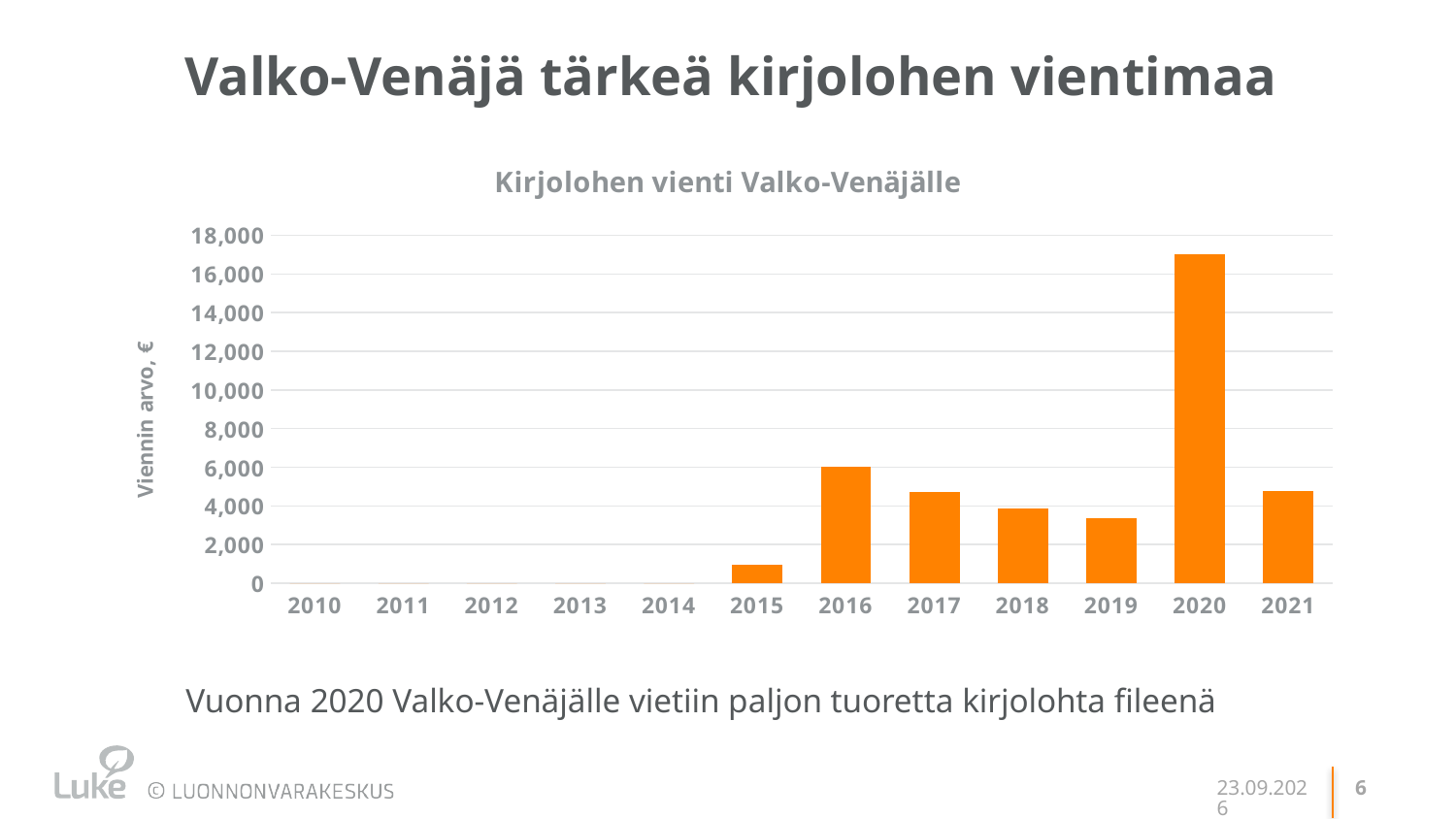
How many years on the chart show no visible bar? 5 Is the value for 2020 greater or less than 16,000? greater Do the values rise or fall from 2016 to 2019? fall How many years are shown on the x axis? 12 Is the value for 2016 greater or less than 4,000? greater Which year has the highest export value? 2020 Is the value for 2015 greater or less than 2,000? less What is the label of the vertical axis? Viennin arvo, € What is the title of the chart? Kirjolohen vienti Valko-Venäjälle Which year has the larger value, 2018 or 2019? 2018 What kind of chart is shown on the slide? bar chart Which year has the larger value, 2016 or 2017? 2016